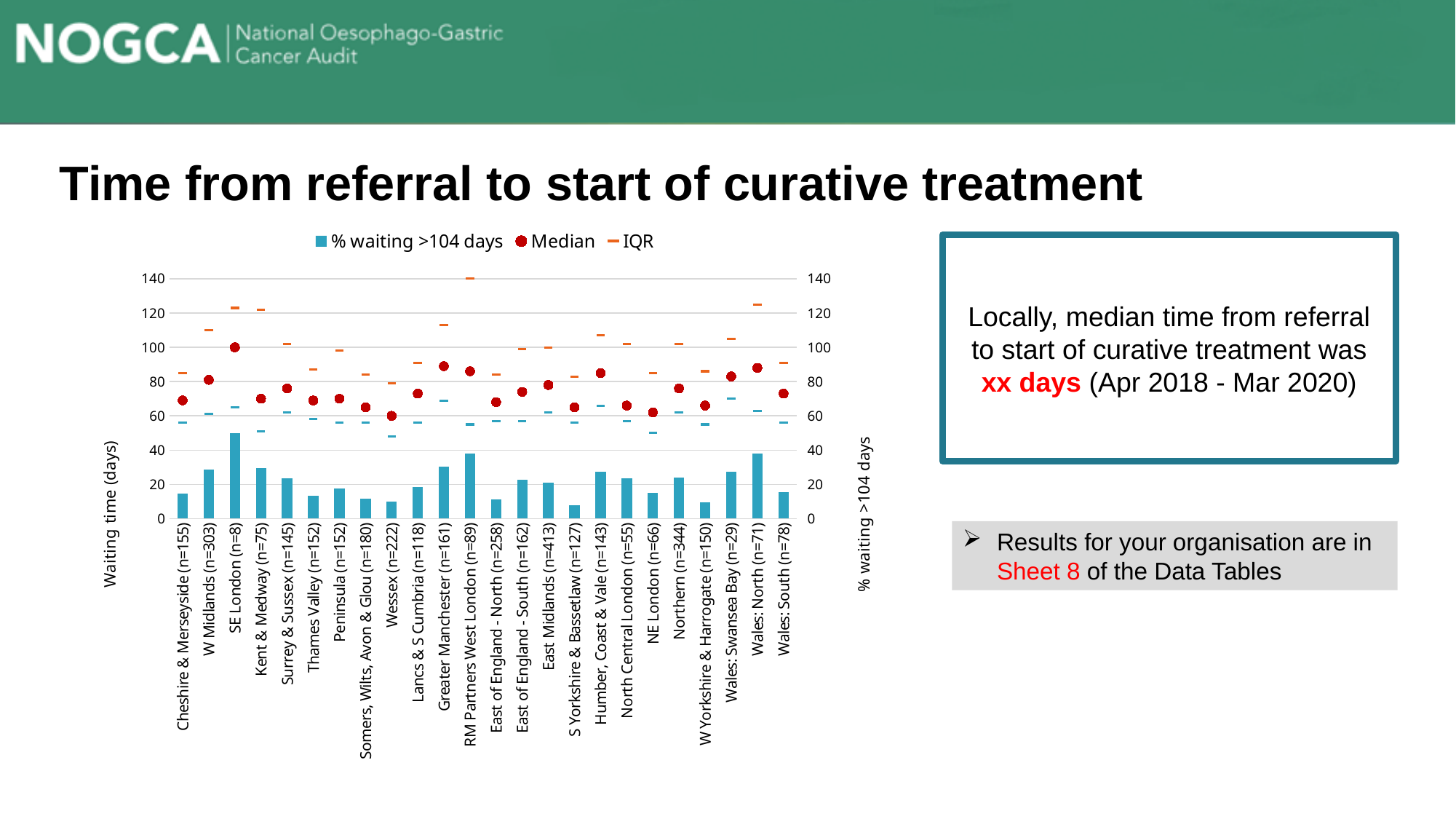
What is the title of the left-hand vertical axis of the chart? Waiting time (days) Which organisation has the highest median waiting time? SE London (n=8) Is the % waiting >104 days for RM Partners West London (n=89) greater or less than 20? greater Which has a higher median waiting time, Greater Manchester (n=161) or Wessex (n=222)? Greater Manchester (n=161) Which organisation has the highest % waiting >104 days? SE London (n=8) What colour are the bars representing % waiting >104 days? Blue What kind of chart is used to show the % waiting >104 days series? Bar chart Is the % waiting >104 days for SE London (n=8) greater or less than 40? greater Which has a higher % waiting >104 days, SE London (n=8) or W Midlands (n=303)? SE London (n=8) How many series does the chart legend list? 3 How many organisations (categories) are shown along the x axis of the chart? 24 Is the median waiting time for Wessex (n=222) greater or less than 80 days? less